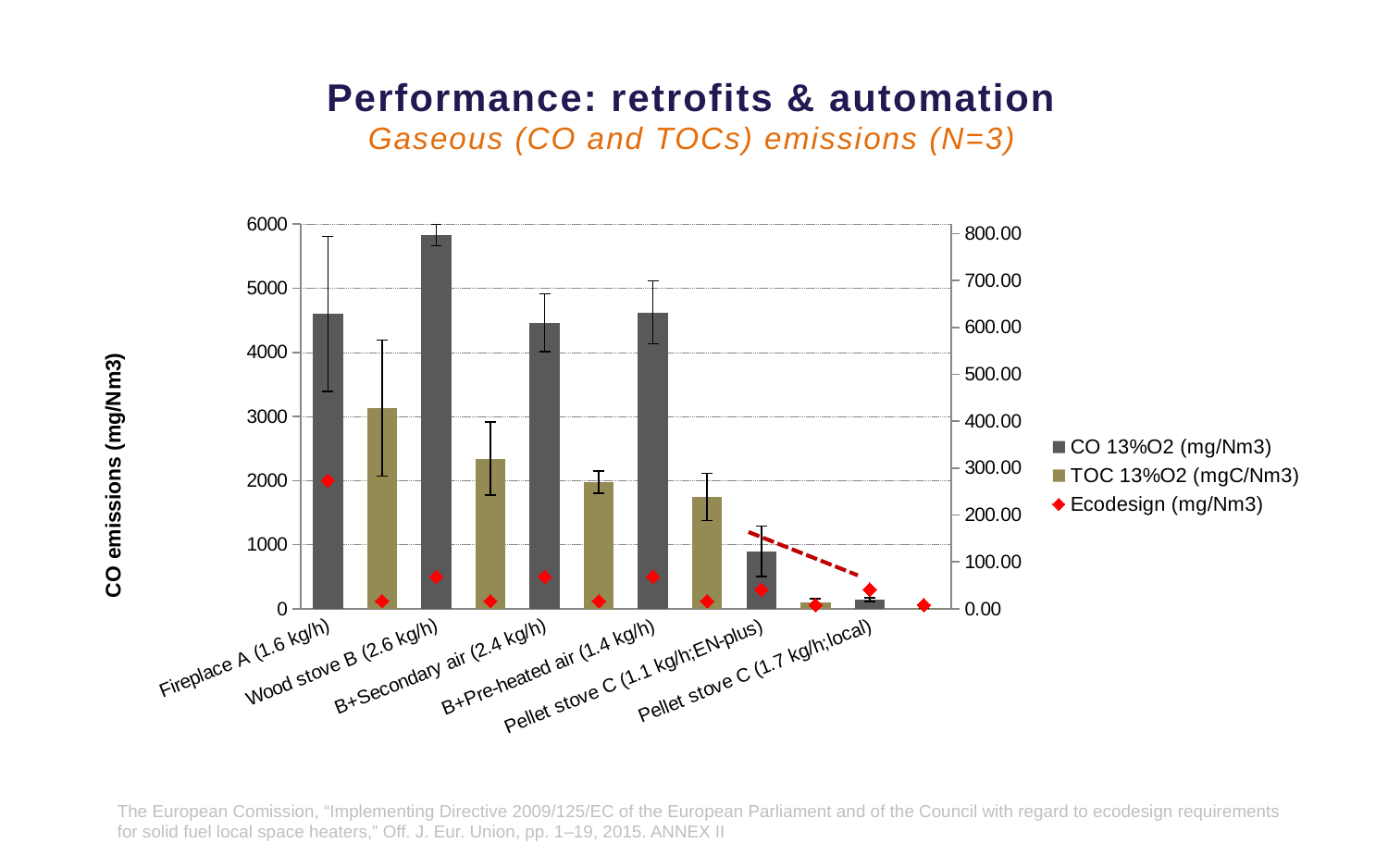
Which category has the lowest CO 13%O2 (mg/Nm3) value? Pellet stove C (1.7 kg/h;local) How many categories are shown on the x axis of the chart? 6 What kind of chart is shown on the slide? bar chart Is the CO 13%O2 (mg/Nm3) value for Wood stove B (2.6 kg/h) greater or less than 5000? greater Do the TOC 13%O2 (mgC/Nm3) values rise or fall from left to right along the x axis? fall How many series does the chart legend list? 3 Which category has the highest TOC 13%O2 (mgC/Nm3) value? Fireplace A (1.6 kg/h) Is the TOC 13%O2 (mgC/Nm3) value for B+Secondary air (2.4 kg/h) greater or less than 3000? less Is the CO 13%O2 (mg/Nm3) value for Pellet stove C (1.1 kg/h;EN-plus) greater or less than 2000? less Which has the larger CO 13%O2 (mg/Nm3) value: Wood stove B (2.6 kg/h) or Fireplace A (1.6 kg/h)? Wood stove B (2.6 kg/h) Which category has the highest CO 13%O2 (mg/Nm3) value? Wood stove B (2.6 kg/h) What is the title of the left vertical axis of the chart? CO emissions (mg/Nm3)